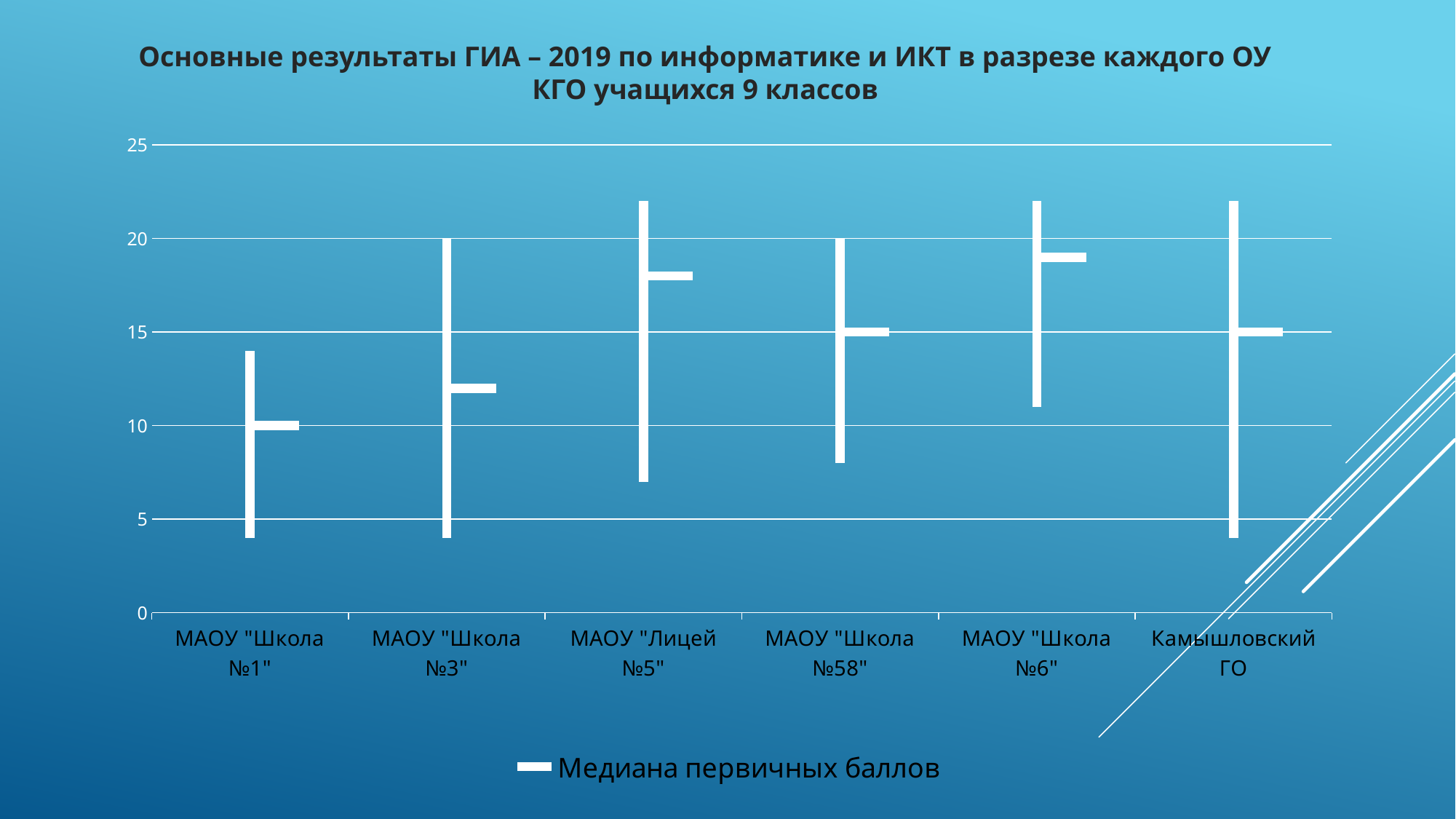
Is the median of primary scores for МАОУ "Лицей №5" greater or less than 15? greater Is the median of primary scores for МАОУ "Школа №3" greater or less than 15? less Which has the larger median of primary scores: МАОУ "Лицей №5" or МАОУ "Школа №3"? МАОУ "Лицей №5" How many series does the chart legend list? 1 How many schools (categories) are shown on the x axis of the chart? 6 What is the title of the chart? Основные результаты ГИА – 2019 по информатике и ИКТ в разрезе каждого ОУ КГО учащихся 9 классов What is the name of the series shown in the chart legend? Медиана первичных баллов Which school has the lowest median of primary scores? МАОУ "Школа №1" Which has the larger median of primary scores: МАОУ "Школа №6" or МАОУ "Школа №1"? МАОУ "Школа №6" Is the median of primary scores for МАОУ "Школа №1" greater or less than 15? less